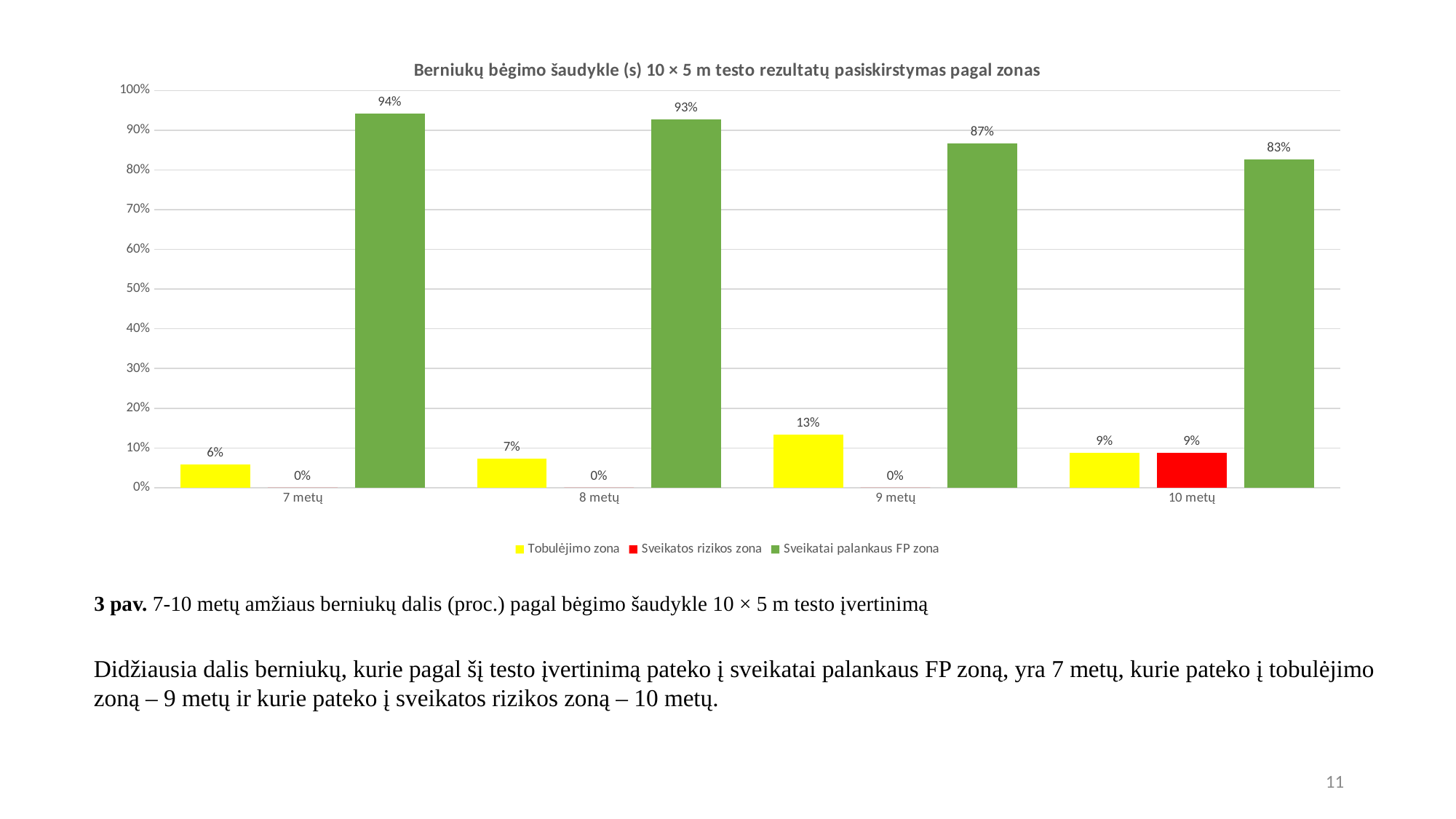
What kind of chart is shown on the slide? bar chart Is the value for Sveikatai palankaus FP zona for 9 metų greater or less than 80%? greater What is the value for Sveikatos rizikos zona for 10 metų? 9% How many series does the legend list? 3 Do the Sveikatai palankaus FP zona values rise or fall from 7 metų to 10 metų? fall What is the value for Sveikatai palankaus FP zona for 7 metų? 94% How many age groups are shown on the x axis? 4 Which age group has the lowest value for Tobulėjimo zona? 7 metų What is the difference between the Sveikatai palankaus FP zona values for 7 metų and 10 metų? 11% Which is larger: the Tobulėjimo zona value for 8 metų or for 9 metų? 9 metų What is the value for Tobulėjimo zona for 9 metų? 13% Which age group has the highest value for Sveikatai palankaus FP zona? 7 metų